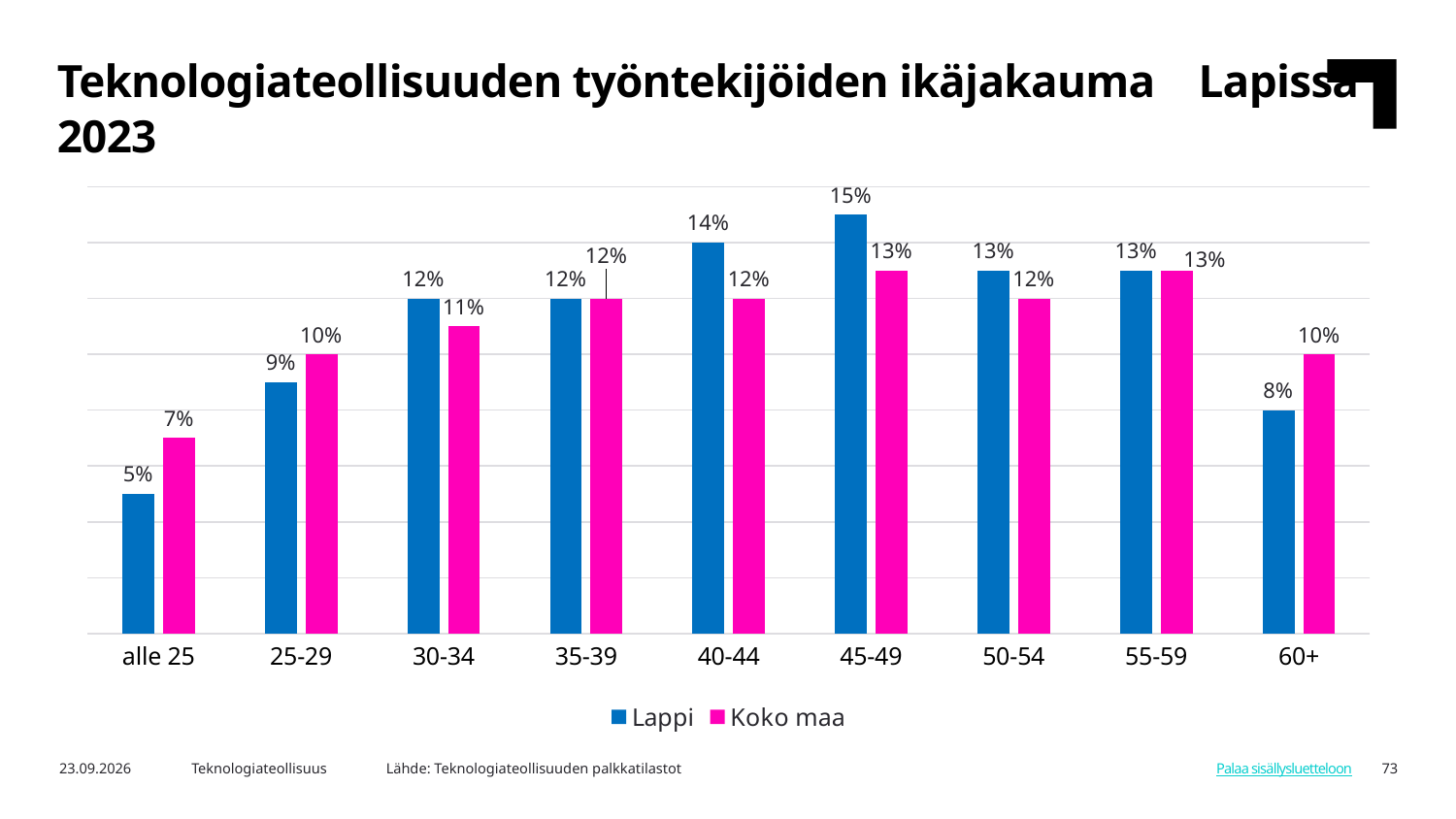
What kind of chart is shown on the slide? Bar chart How many series does the legend list? 2 Which age group has the highest value for Lappi? 45-49 Which age group has the lowest value for Koko maa? alle 25 What is the value for Lappi in the 60+ age group? 8% What is the value for Lappi in the 45-49 age group? 15% How many age groups are shown on the x axis? 9 Which is larger in the 45-49 age group, Lappi or Koko maa? Lappi What is the difference between the Lappi and Koko maa values in the 40-44 age group? 2% What is the value for Koko maa in the alle 25 age group? 7% Which series is shown in pink? Koko maa Which is larger in the 25-29 age group, Lappi or Koko maa? Koko maa